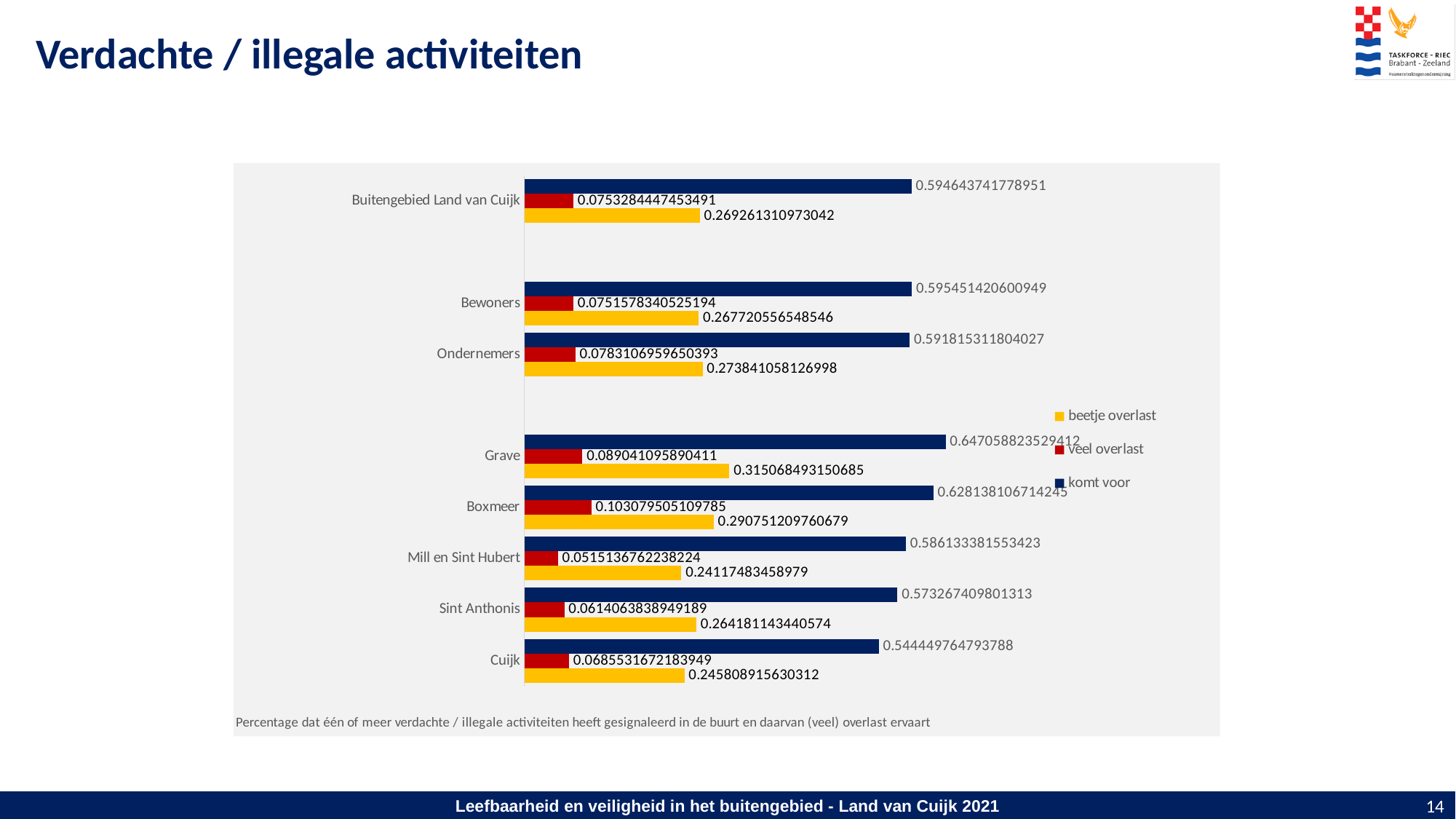
What is the 'beetje overlast' value for Grave? 0.315068493150685 What is the 'veel overlast' value for Bewoners? 0.0751578340525194 What is the 'komt voor' value for Buitengebied Land van Cuijk? 0.594643741778951 Which category has the highest 'veel overlast' value? Boxmeer What is the 'veel overlast' value for Cuijk? 0.0685531672183949 Which category has the highest 'komt voor' value? Grave Which colour represents the 'komt voor' series in the legend? dark blue Which category has the lowest 'veel overlast' value? Mill en Sint Hubert What kind of chart is shown on the slide? bar chart How many categories are shown on the vertical axis of the chart? 8 What is the 'beetje overlast' value for Ondernemers? 0.273841058126998 How many series does the legend list? 3